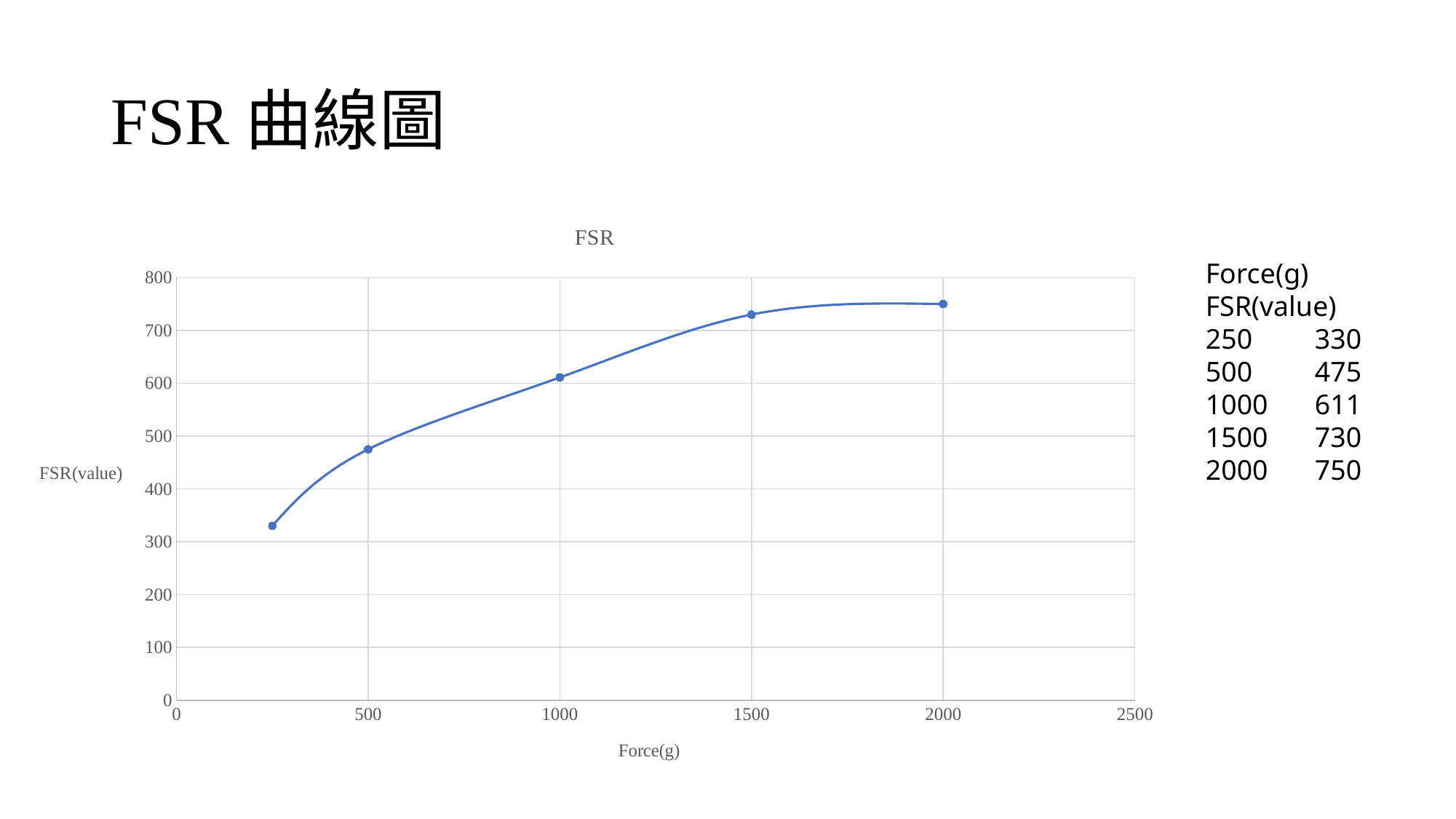
At which force is the FSR value lowest? 250 At which force is the FSR value highest? 2000 What is the FSR value at a force of 250 g? 330 What is the difference between the FSR value at 1500 g and at 500 g? 255 What is the title of the chart? FSR How many data points are plotted on the chart? 5 What is the label of the x axis? Force(g) What type of chart is shown on the slide? line chart Which is larger, the FSR value at 500 g or at 1000 g? 1000 g What is the FSR value at a force of 2000 g? 750 What is the FSR value at a force of 1000 g? 611 Does the FSR value rise or fall as force increases along the x axis? rise